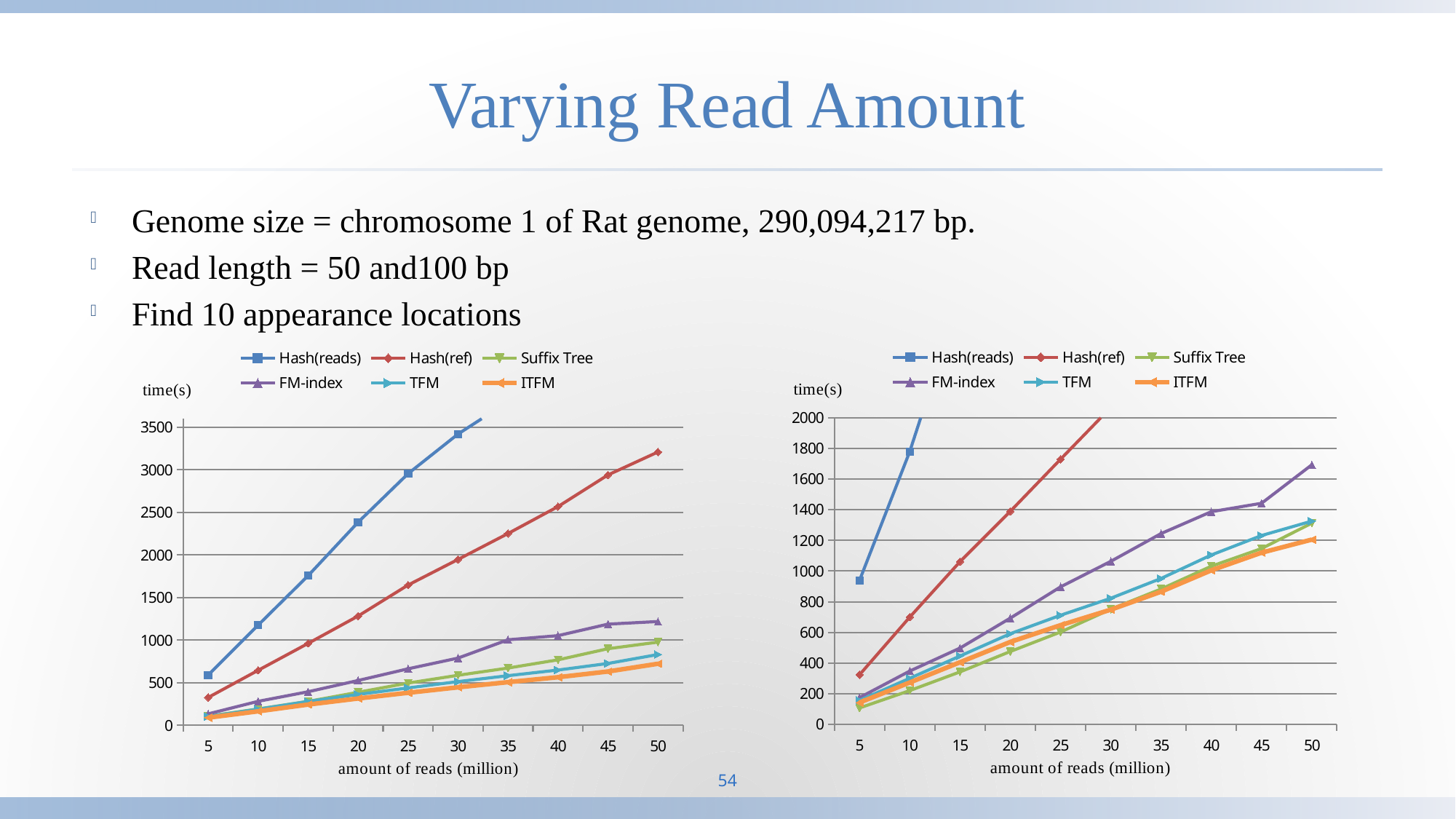
On the left chart, which series has the lowest value at 50 million reads? ITFM What kind of chart is the chart on the left of the slide? line chart On the left chart, is the value for Hash(reads) at 30 million reads greater or less than 3000? greater On the left chart, which series has the highest value at 25 million reads? Hash(reads) On the right chart, which is larger at 40 million reads: FM-index or TFM? FM-index How many series does the legend of the left chart list? 6 On the right chart, is the value for Suffix Tree at 15 million reads greater or less than 400? less On the left chart, does the time for Hash(ref) rise or fall as the amount of reads increases? rise What is the x-axis label of the right chart? amount of reads (million) How many x-axis values (amounts of reads) are shown on the right chart? 10 On the left chart, is the value for ITFM at 50 million reads greater or less than 1000? less